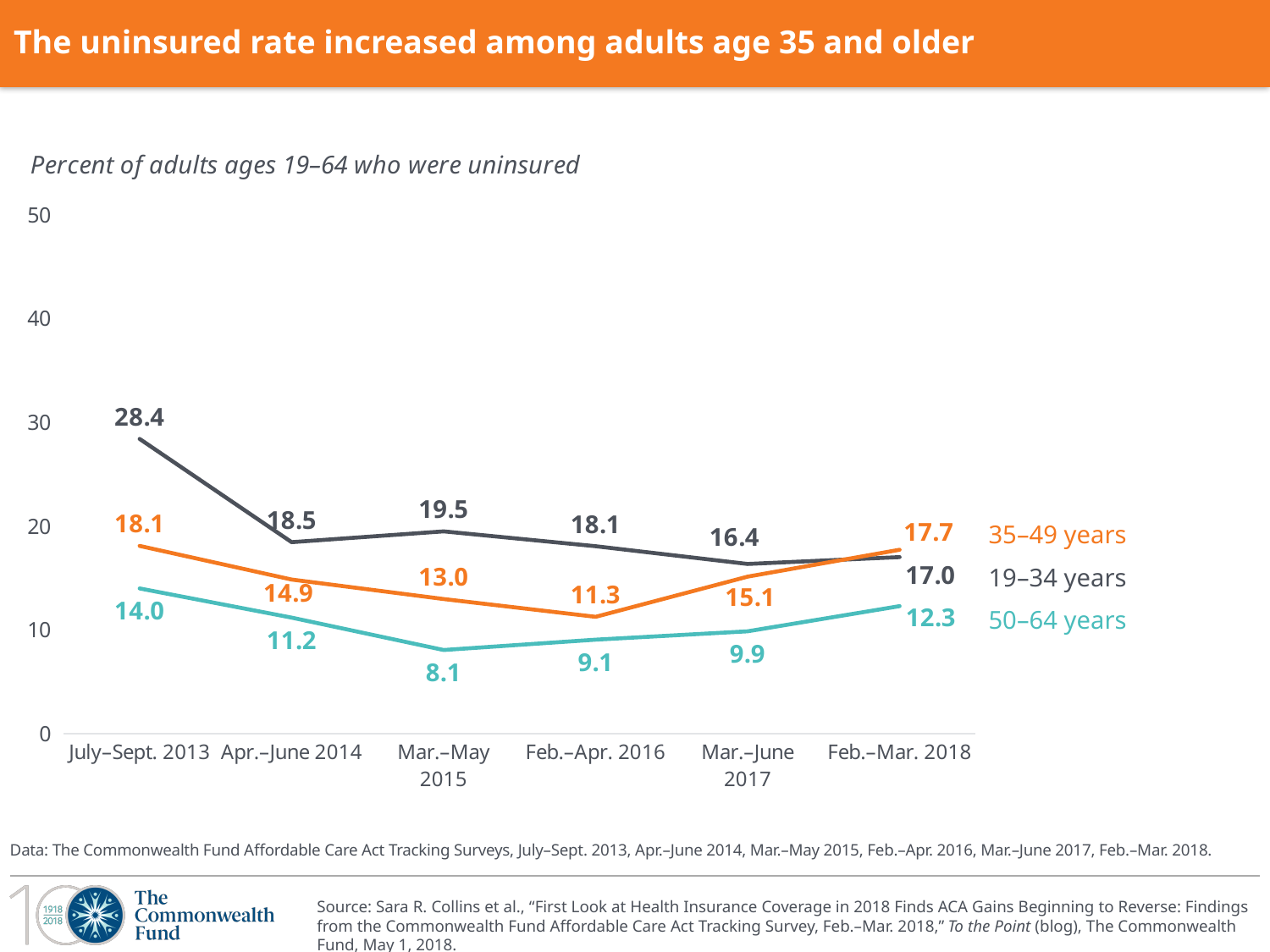
What is the subtitle describing the measure plotted on the chart? Percent of adults ages 19–64 who were uninsured What is the difference between the uninsured rate for ages 35–49 in Feb.–Mar. 2018 and in Feb.–Apr. 2016? 6.4 How many age groups (series) are plotted on the chart? 3 What was the uninsured rate for adults ages 35–49 in Feb.–Mar. 2018? 17.7 How many survey periods are shown on the x axis? 6 In which survey period was the uninsured rate for adults ages 19–34 highest? July–Sept. 2013 What was the uninsured rate for adults ages 50–64 in Mar.–May 2015? 8.1 In which survey period was the uninsured rate for adults ages 50–64 lowest? Mar.–May 2015 Did the uninsured rate for adults ages 50–64 rise or fall between Mar.–May 2015 and Feb.–Mar. 2018? rise What was the uninsured rate for adults ages 19–34 in July–Sept. 2013? 28.4 What type of chart is shown on the slide? line chart Which age group had the higher uninsured rate in Feb.–Mar. 2018: 35–49 years or 19–34 years? 35–49 years